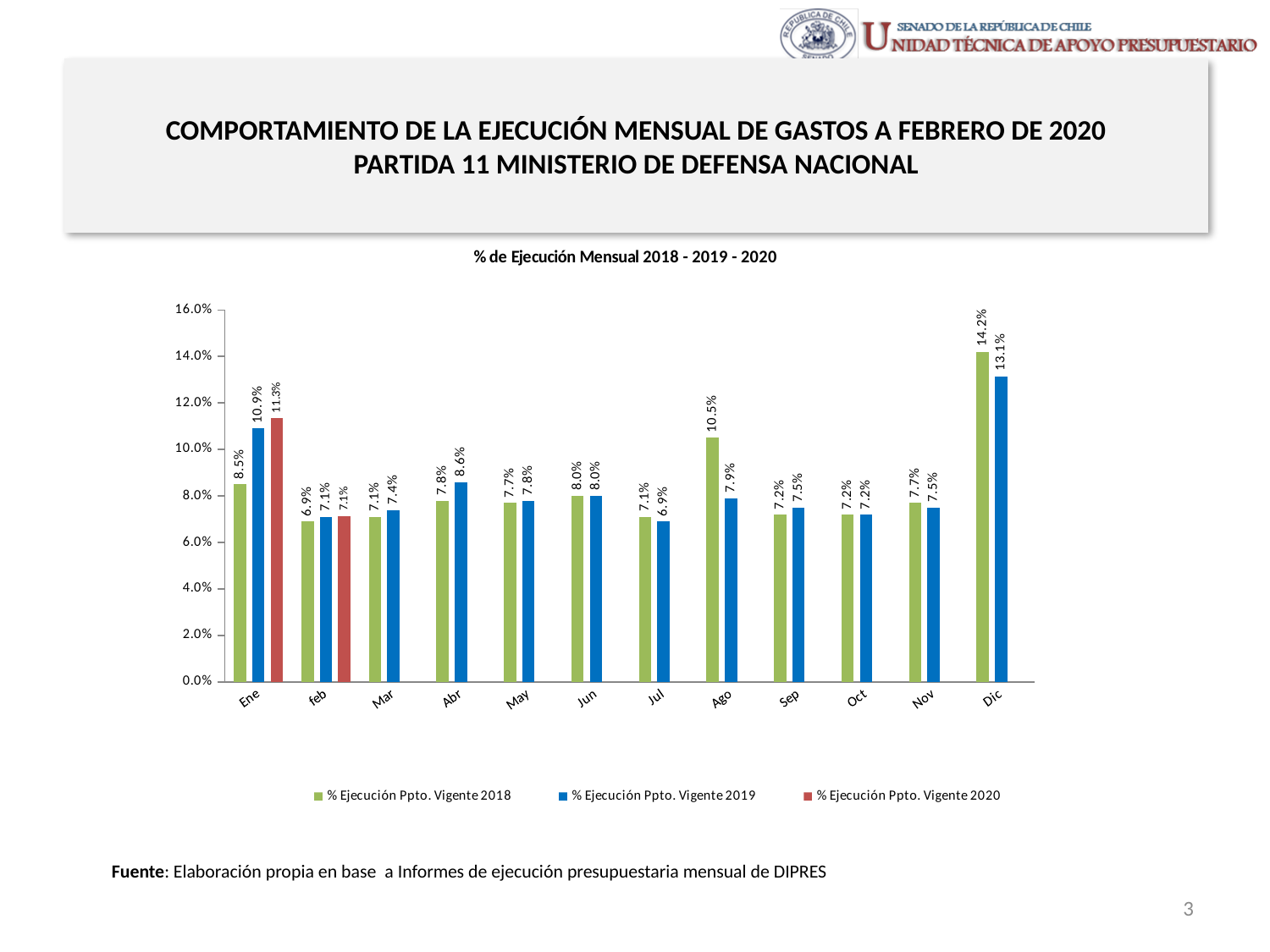
Which month has the lowest % Ejecución Ppto. Vigente 2019 value? Jul Which is larger for Abr: the 2018 value or the 2019 value? 2019 What is the % Ejecución Ppto. Vigente 2018 value for Ago? 10.5% What is the title of the chart? % de Ejecución Mensual 2018 - 2019 - 2020 Is the % Ejecución Ppto. Vigente 2018 value for Dic greater or less than 12.0%? greater What is the % Ejecución Ppto. Vigente 2020 value for Ene? 11.3% How many series does the legend list? 3 What kind of chart is shown? bar chart Which month has the highest % Ejecución Ppto. Vigente 2018 value? Dic How many months are shown on the x axis? 12 What is the difference between the 2018 and 2019 values for Ene? 2.4% What is the % Ejecución Ppto. Vigente 2019 value for Dic? 13.1%